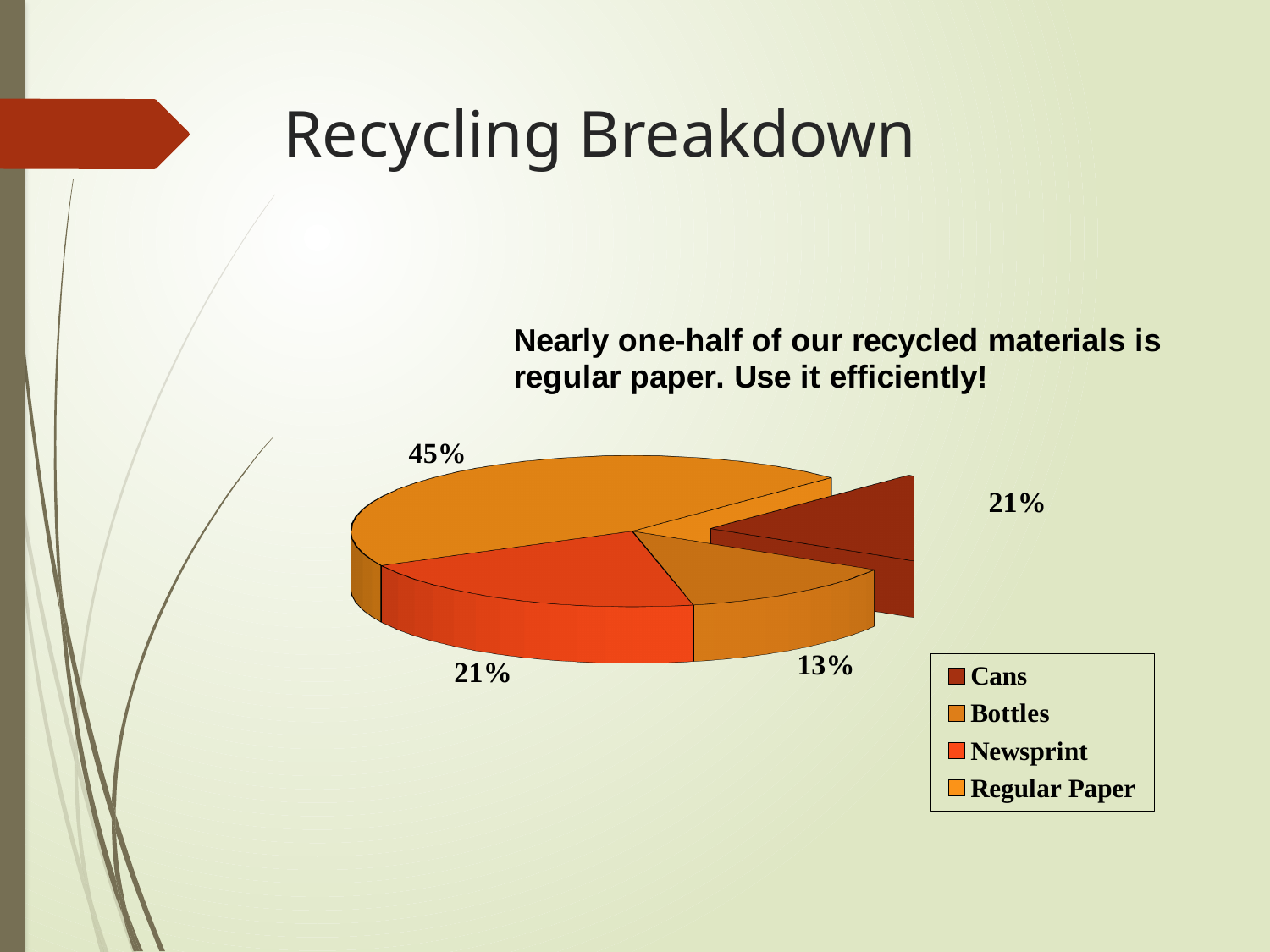
Which category has the smallest slice of the pie? Bottles How many categories are shown in the pie chart? 4 What is the difference in percentage points between Regular Paper and Newsprint? 24 What is the difference in percentage points between Regular Paper and Bottles? 32 What type of chart is shown on the slide? Pie chart Which is larger, the share for Bottles or the share for Cans? Cans What percentage is shown for Bottles? 13% What share of the pie does Regular Paper represent? 45% What percentage is shown for Newsprint? 21% What percentage is shown for Cans? 21% Which slice is pulled out (exploded) from the rest of the pie? Cans Which category has the largest slice of the pie? Regular Paper